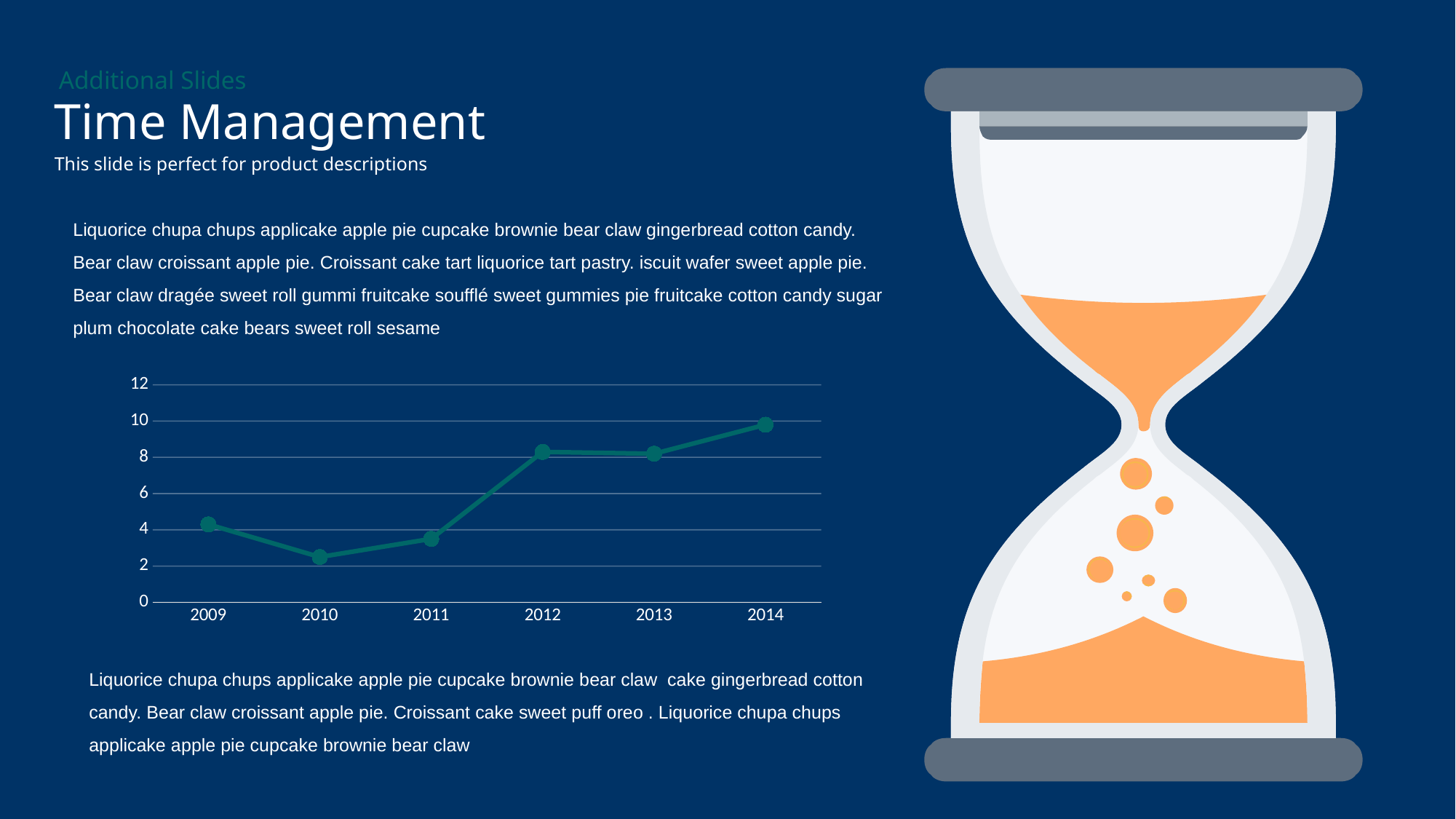
Which year has the highest value in the chart? 2014 What is the highest value shown on the y axis of the chart? 12 Which year has the larger value, 2009 or 2014? 2014 Is the value for 2009 greater or less than 6? less Which year has the lowest value in the chart? 2010 Is the value for 2012 greater or less than 6? greater Is the value for 2014 greater or less than 8? greater How many years are plotted on the x axis of the chart? 6 Does the line rise or fall from 2011 to 2014? rise Which year has the larger value, 2011 or 2012? 2012 What kind of chart is shown on the slide? line chart